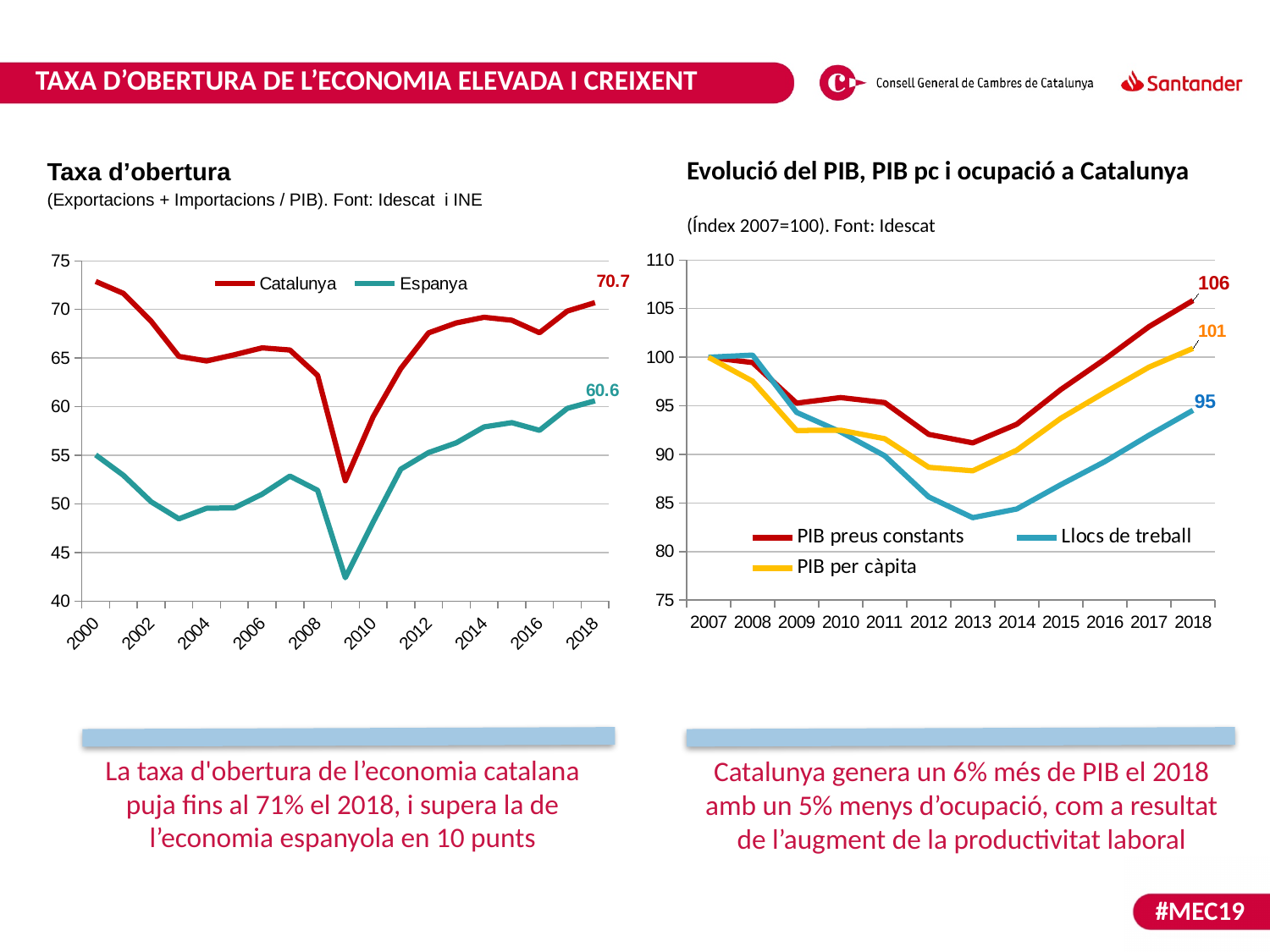
In the 'Evolució del PIB, PIB pc i ocupació a Catalunya' chart, what is the value for Llocs de treball in 2018? 95 In the 'Taxa d'obertura' chart, what is the value for Espanya in 2018? 60.6 In the 'Evolució del PIB, PIB pc i ocupació a Catalunya' chart, is the value for Llocs de treball in 2013 greater or less than 85? less In the 'Taxa d'obertura' chart, is the value for Espanya in 2009 greater or less than 45? less In the 'Taxa d'obertura' chart, what is the value for Catalunya in 2018? 70.7 In the 'Taxa d'obertura' chart, how many series does the legend list? 2 In the 'Taxa d'obertura' chart, what is the difference between the Catalunya and Espanya values in 2018? 10.1 What kind of chart is the 'Taxa d'obertura' chart? line chart In the 'Evolució del PIB, PIB pc i ocupació a Catalunya' chart, what is the value for PIB preus constants in 2018? 106 In the 'Taxa d'obertura' chart, which series is higher in 2018, Catalunya or Espanya? Catalunya In the 'Evolució del PIB, PIB pc i ocupació a Catalunya' chart, how many series does the legend list? 3 In the 'Evolució del PIB, PIB pc i ocupació a Catalunya' chart, which series has the highest value in 2018? PIB preus constants